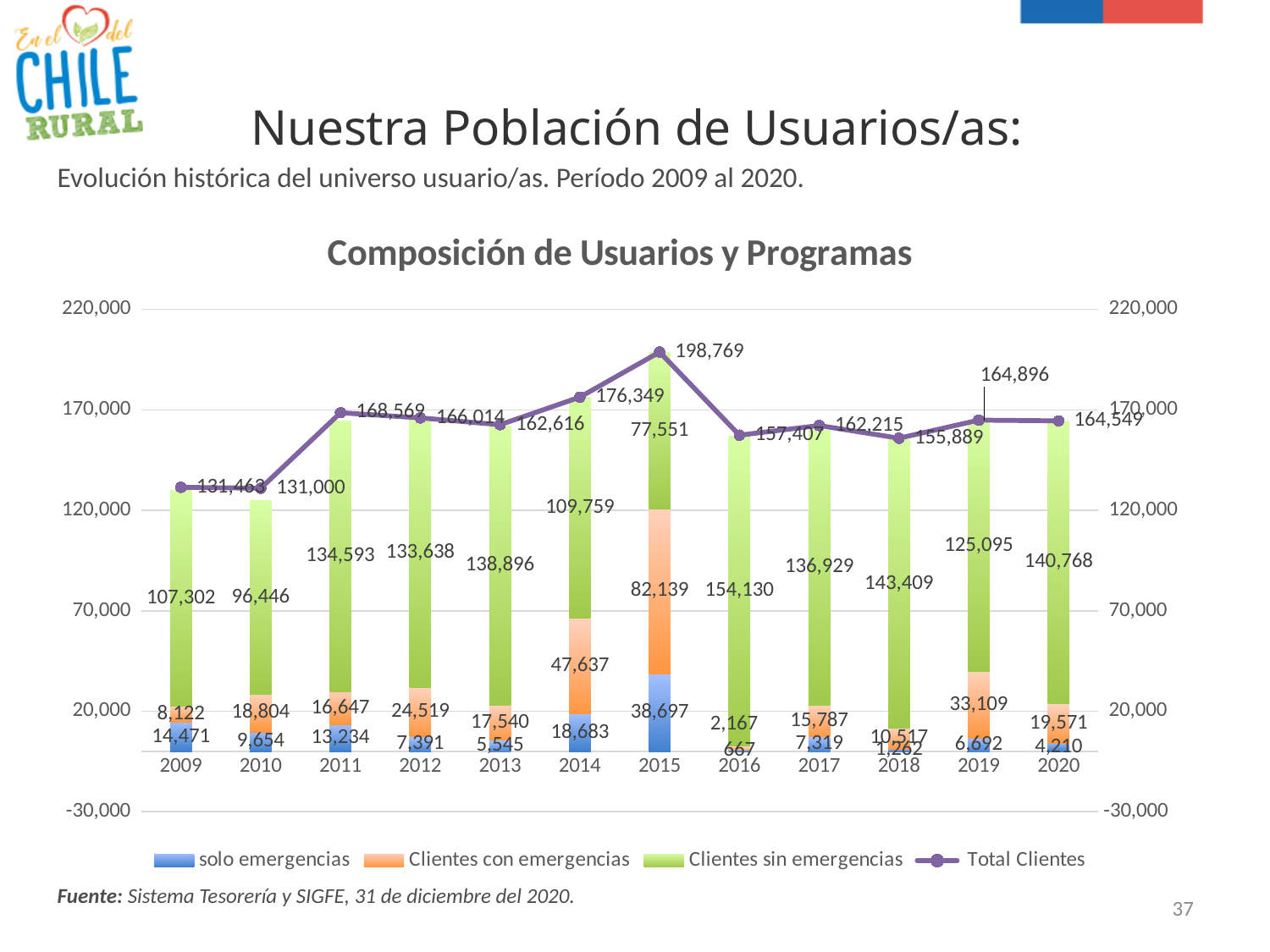
What is the difference between Total Clientes in 2015 and in 2014? 22,420 In which year is Total Clientes highest? 2015 How many series does the legend list? 4 What is the value of Clientes sin emergencias in 2016? 154,130 In which year is solo emergencias lowest? 2016 What kind of chart is shown on the slide? Bar chart with a line What is the value of solo emergencias in 2015? 38,697 What is the value of Total Clientes in 2015? 198,769 How many years are shown on the x axis? 12 In which year is Total Clientes lowest? 2010 Which year has the larger value for Clientes con emergencias, 2014 or 2019? 2014 What is the title of the chart? Composición de Usuarios y Programas